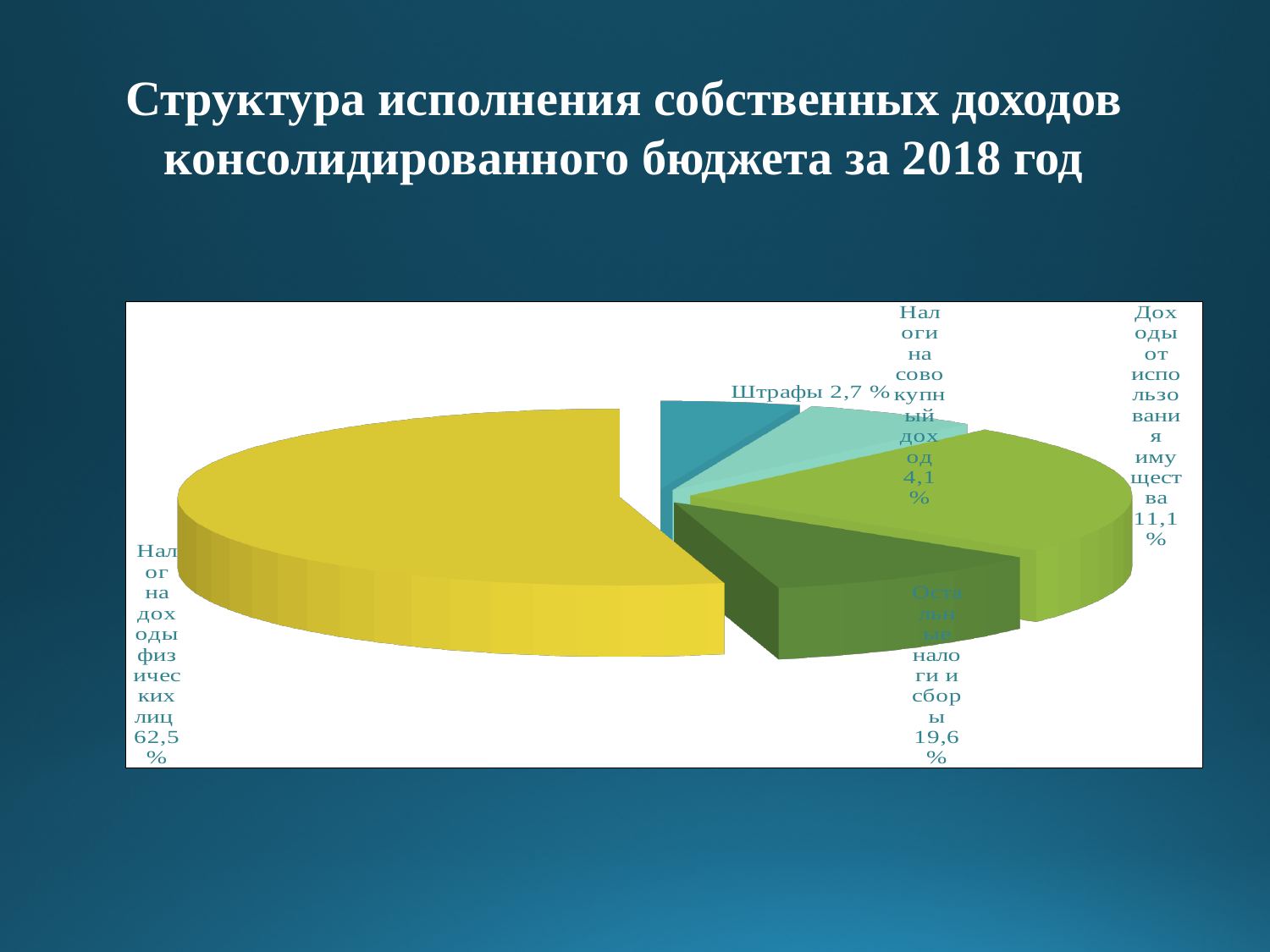
What is the title of the slide containing the chart? Структура исполнения собственных доходов консолидированного бюджета за 2018 год What share is shown for Налоги на совокупный доход? 4,1 % What kind of chart is shown on the slide? Pie chart How many slices does the pie chart have? 5 What share is shown for Доходы от использования имущества? 11,1 % What share is shown for Штрафы? 2,7 % What share of the pie is labelled for Налог на доходы физических лиц? 62,5 % What is the difference between the shares of Остальные налоги и сборы and Доходы от использования имущества? 8,5 % Which slice of the pie is the largest? Налог на доходы физических лиц Which is larger: the share for Налоги на совокупный доход or the share for Штрафы? Налоги на совокупный доход What share is shown for Остальные налоги и сборы? 19,6 % Which slice of the pie is the smallest? Штрафы